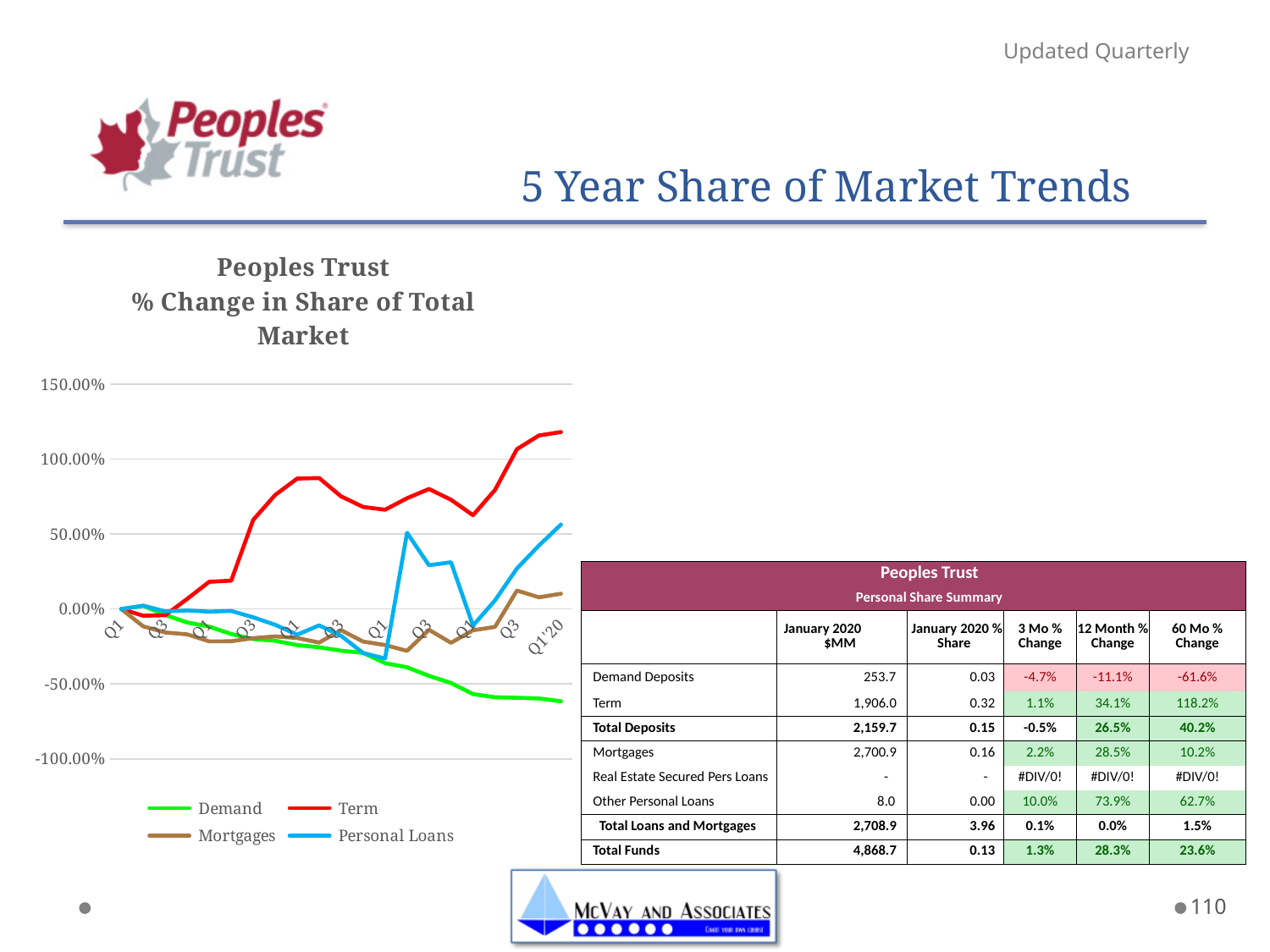
What kind of chart is shown on the slide? line chart Is the value for Term at Q1'20 greater or less than 100.00%? greater Which series has the lowest value at Q1'20? Demand Does the Term line generally rise or fall across the x axis? rise How many series does the chart legend list? 4 Does the Demand line generally rise or fall across the x axis? fall Which series reaches the highest value on the chart? Term Which colour is used for the Term line in the chart? red Is the value for Demand at Q1'20 greater or less than -50.00%? less Is the value for Personal Loans at Q1'20 greater or less than 0.00%? greater At Q1'20, which is larger: the value for Term or the value for Mortgages? Term What is the title of the chart? Peoples Trust % Change in Share of Total Market